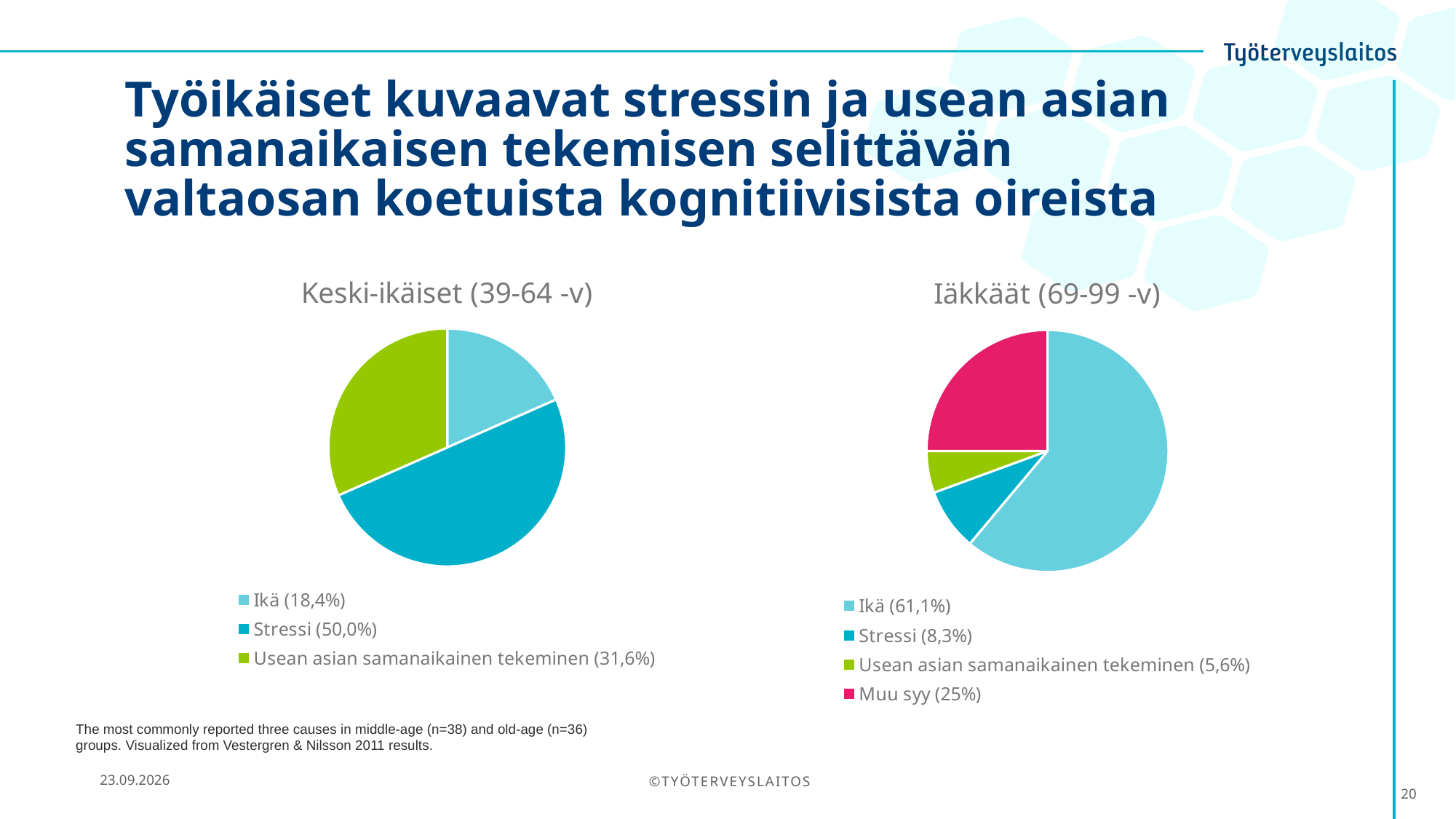
In the 'Iäkkäät (69-99 -v)' pie chart, what share is shown for Usean asian samanaikainen tekeminen? 5,6% How many categories does the 'Iäkkäät (69-99 -v)' pie chart have? 4 In the 'Keski-ikäiset (39-64 -v)' pie chart, which category has the largest share? Stressi In the 'Iäkkäät (69-99 -v)' pie chart, which is larger: Stressi or Muu syy? Muu syy In the 'Keski-ikäiset (39-64 -v)' pie chart, what share is shown for Ikä? 18,4% How many categories does the 'Keski-ikäiset (39-64 -v)' pie chart have? 3 In the 'Iäkkäät (69-99 -v)' pie chart, which category has the largest share? Ikä In the 'Iäkkäät (69-99 -v)' pie chart, what share is shown for Muu syy? 25% In the 'Keski-ikäiset (39-64 -v)' pie chart, what share is shown for Stressi? 50,0% In the 'Keski-ikäiset (39-64 -v)' pie chart, what is the difference in percentage points between Stressi and Ikä? 31,6 What type of chart is used for 'Keski-ikäiset (39-64 -v)'? Pie chart In the 'Iäkkäät (69-99 -v)' pie chart, which category has the smallest share? Usean asian samanaikainen tekeminen